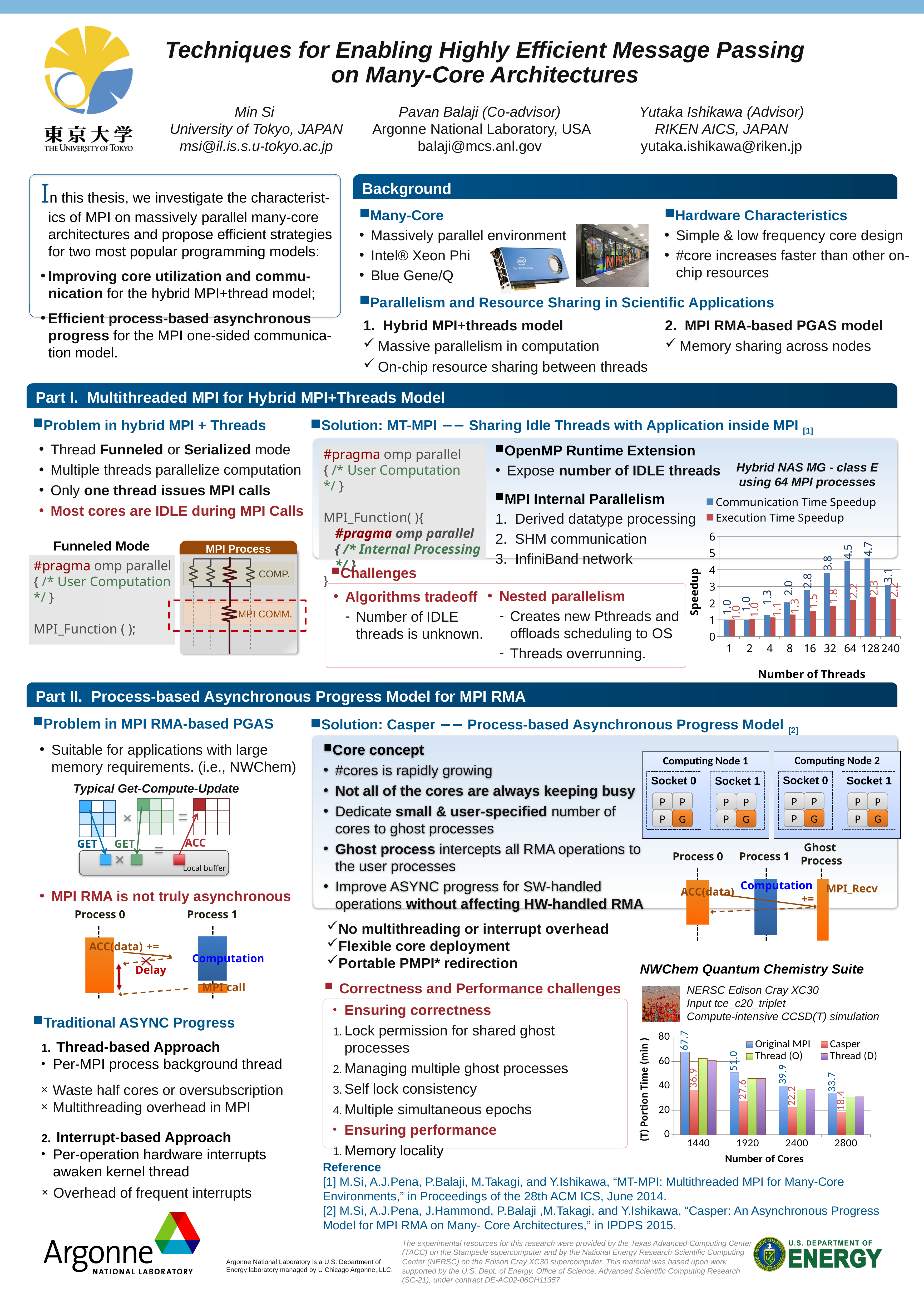
In the Hybrid NAS MG chart, at which number of threads is the Communication Time Speedup highest? 128 In the Hybrid NAS MG chart, what is the difference between the Communication Time Speedup and the Execution Time Speedup at 32 threads? 2.0 In the NWChem Quantum Chemistry Suite chart, how many series does the legend list? 4 In the Hybrid NAS MG chart, does the Communication Time Speedup rise or fall from 1 thread to 128 threads? rise In the Hybrid NAS MG chart, how many thread-count categories are shown on the x axis? 9 In the Hybrid NAS MG chart, what is the Execution Time Speedup at 64 threads? 2.2 In the NWChem Quantum Chemistry Suite chart, what is the Casper time at 2800 cores? 18.4 In the Hybrid NAS MG chart, what is the Communication Time Speedup at 128 threads? 4.7 In the NWChem Quantum Chemistry Suite chart, what is the Original MPI time at 1440 cores? 67.7 In the Hybrid NAS MG chart, how many series does the legend list? 2 In the NWChem Quantum Chemistry Suite chart, what is the difference between the Original MPI and Casper times at 1920 cores? 23.4 What kind of chart is the NWChem Quantum Chemistry Suite chart? bar chart